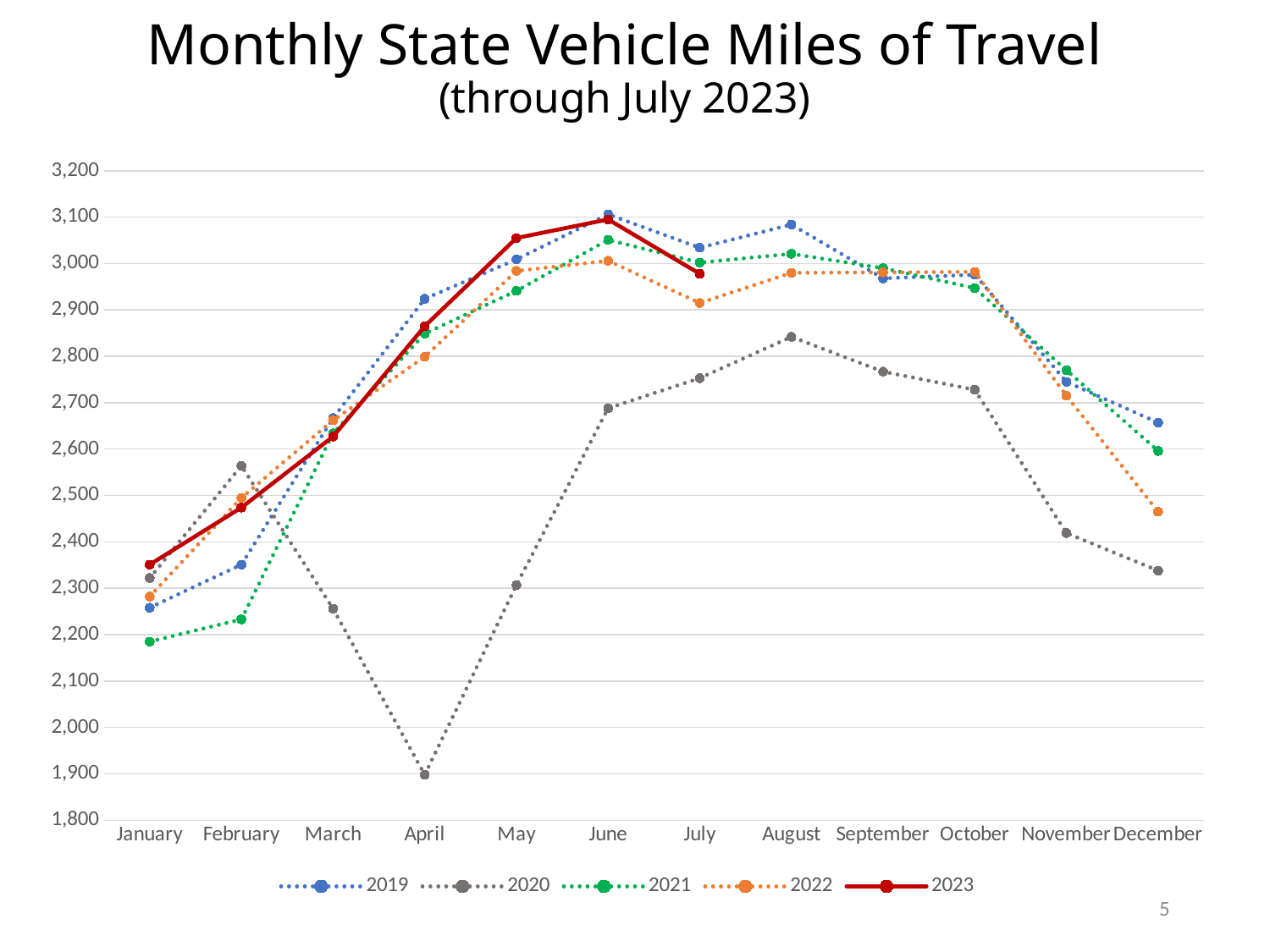
How many months are shown along the x axis? 12 What kind of chart is shown on the slide? line chart In which month does the 2020 series reach its lowest value? April Is the 2022 value for December greater or less than 2,500? less Which series is drawn as a solid line rather than a dotted line? 2023 How many series does the legend list? 5 Is the 2019 value for June greater or less than 3,000? greater Is the 2020 value for April greater or less than 2,000? less Which is larger in December, the 2021 value or the 2022 value? 2021 In which month does the 2023 series reach its highest value? June Which is larger in February, the 2020 value or the 2019 value? 2020 Does the 2023 series rise or fall from January to June? rise